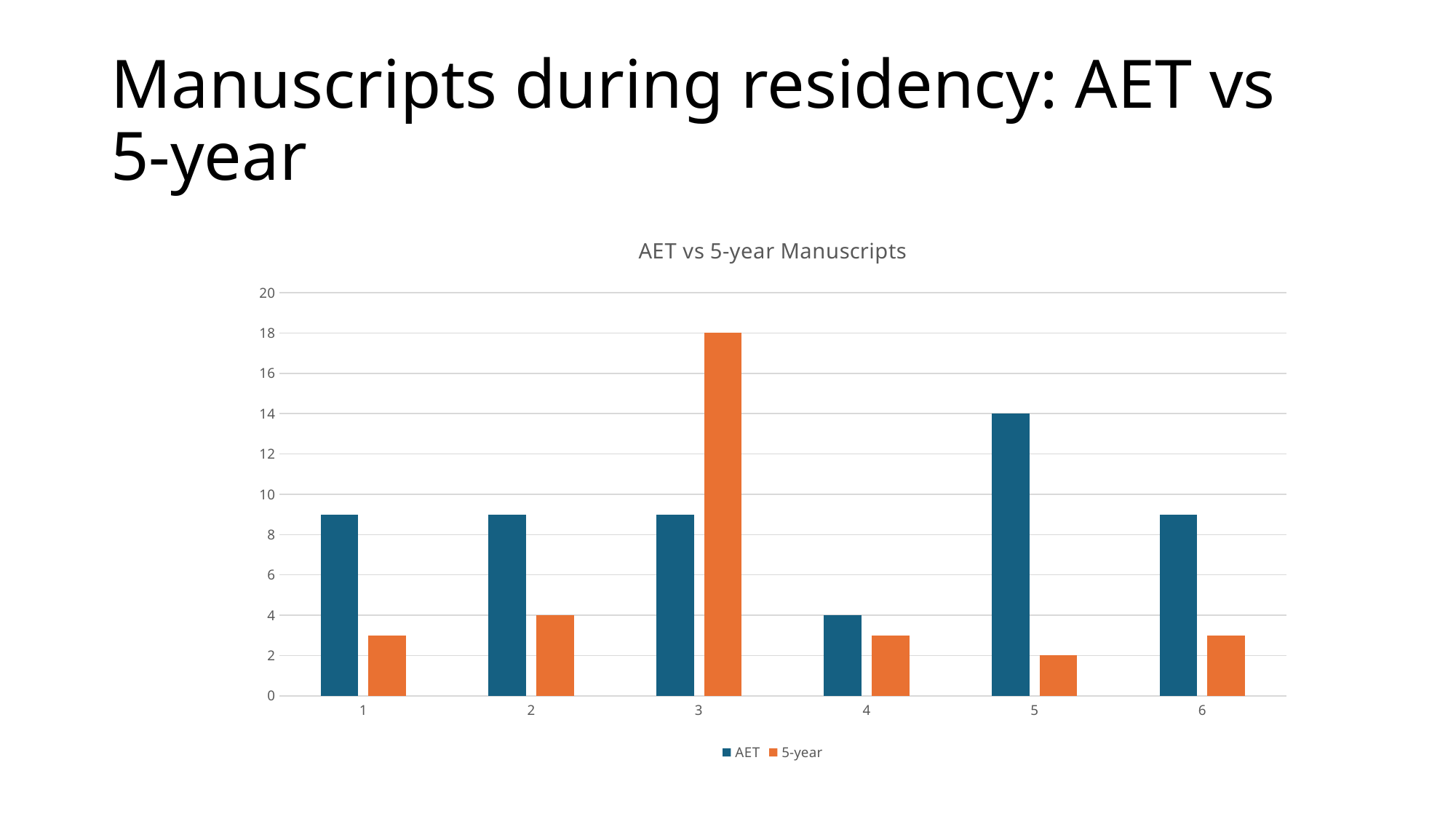
What kind of chart is shown on the slide? bar chart How many series does the legend list? 2 How many categories are shown on the x axis? 6 Is the AET value for category 1 greater or less than 8? greater Which category has the highest 5-year value? 3 What is the 5-year value for category 5? 2 What is the 5-year value for category 3? 18 Which category has the highest AET value? 5 What is the AET value for category 5? 14 What is the title of the chart? AET vs 5-year Manuscripts What is the AET value for category 4? 4 Which is larger for category 3, the AET value or the 5-year value? 5-year